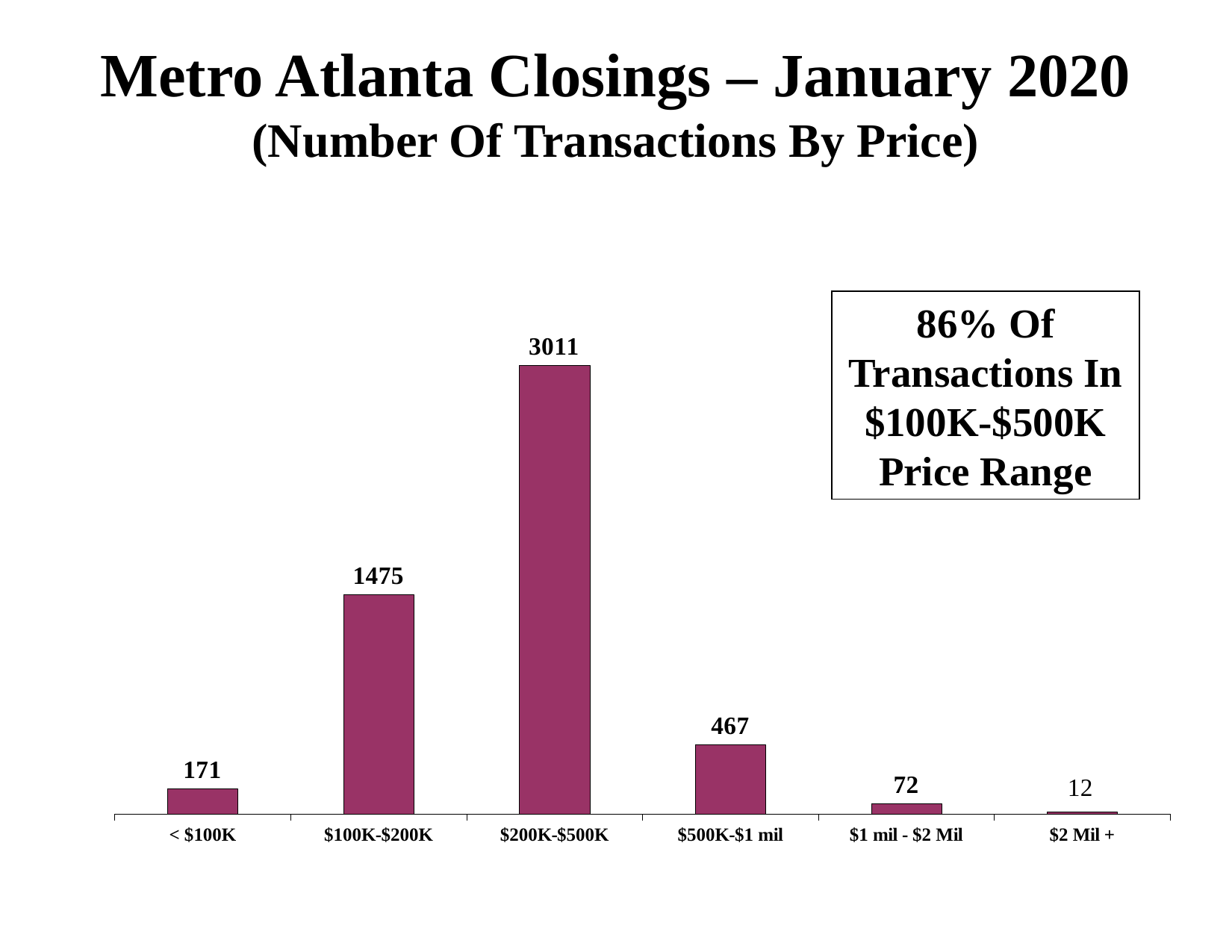
What type of chart is shown on the slide? Bar chart How many transactions were in the $1 mil - $2 Mil range? 72 What is the difference between the $500K-$1 mil and < $100K transaction counts? 296 Which has more transactions, $100K-$200K or $500K-$1 mil? $100K-$200K What is the difference in transactions between the $200K-$500K and $100K-$200K ranges? 1536 What is the total number of transactions across all price ranges shown? 5208 According to the text box on the slide, what percentage of transactions were in the $100K-$500K price range? 86% How many transactions were in the $200K-$500K price range? 3011 How many price range categories are shown on the chart? 6 Which price range has the highest number of transactions? $200K-$500K Which price range has the lowest number of transactions? $2 Mil + What is the number of transactions for the < $100K category? 171